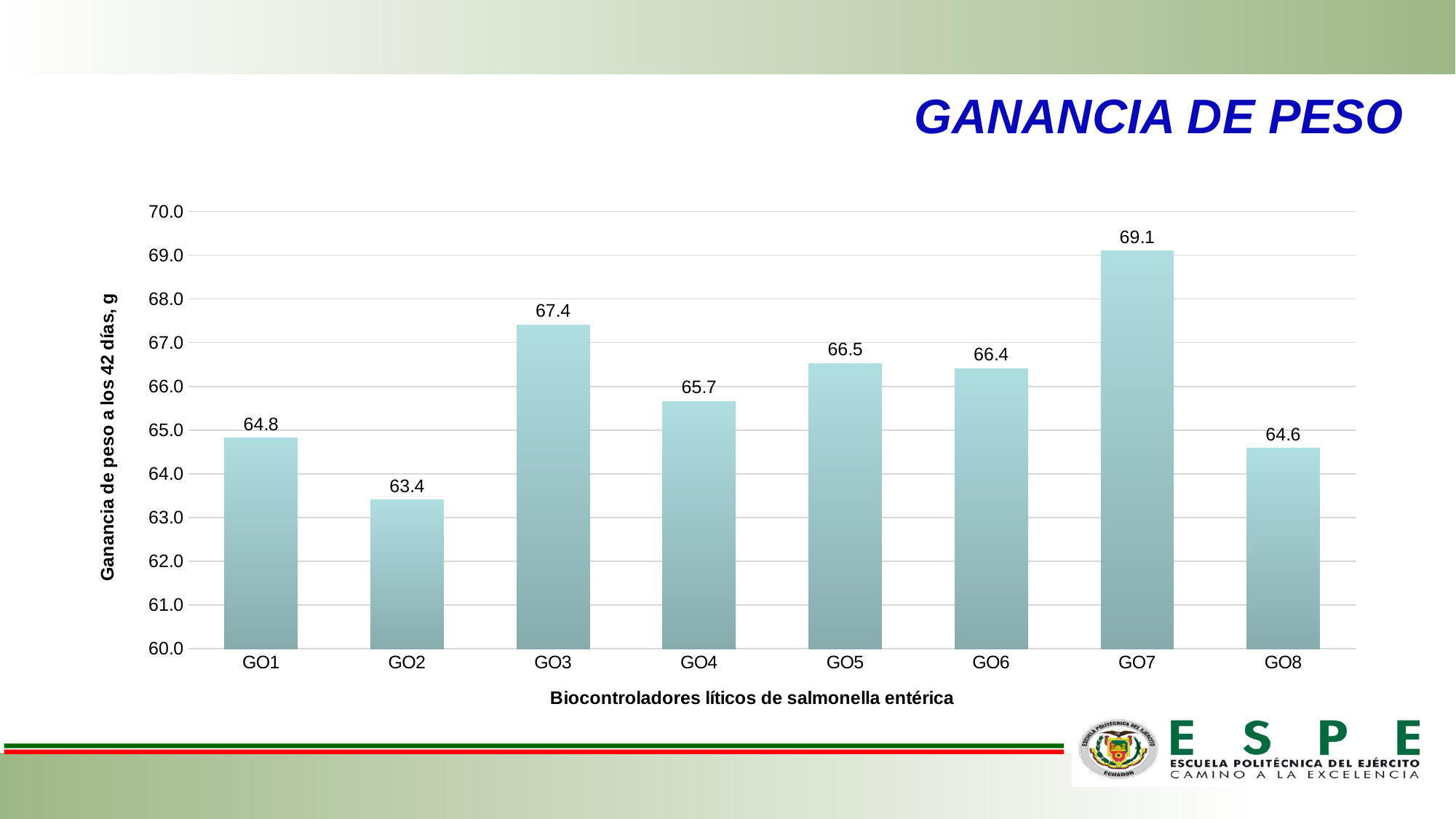
What is the difference between the values for GO3 and GO1? 2.6 Which category has the lowest value? GO2 What is the title of the slide? GANANCIA DE PESO What is the value for GO8? 64.6 Is the value for GO1 greater or less than 64.0? greater What is the label of the x axis? Biocontroladores líticos de salmonella entérica What is the difference between the values for GO7 and GO2? 5.7 Which category has the highest value? GO7 What is the value for GO3? 67.4 What kind of chart is shown on the slide? bar chart Which is larger, the value for GO5 or the value for GO4? GO5 How many categories are shown on the x axis? 8